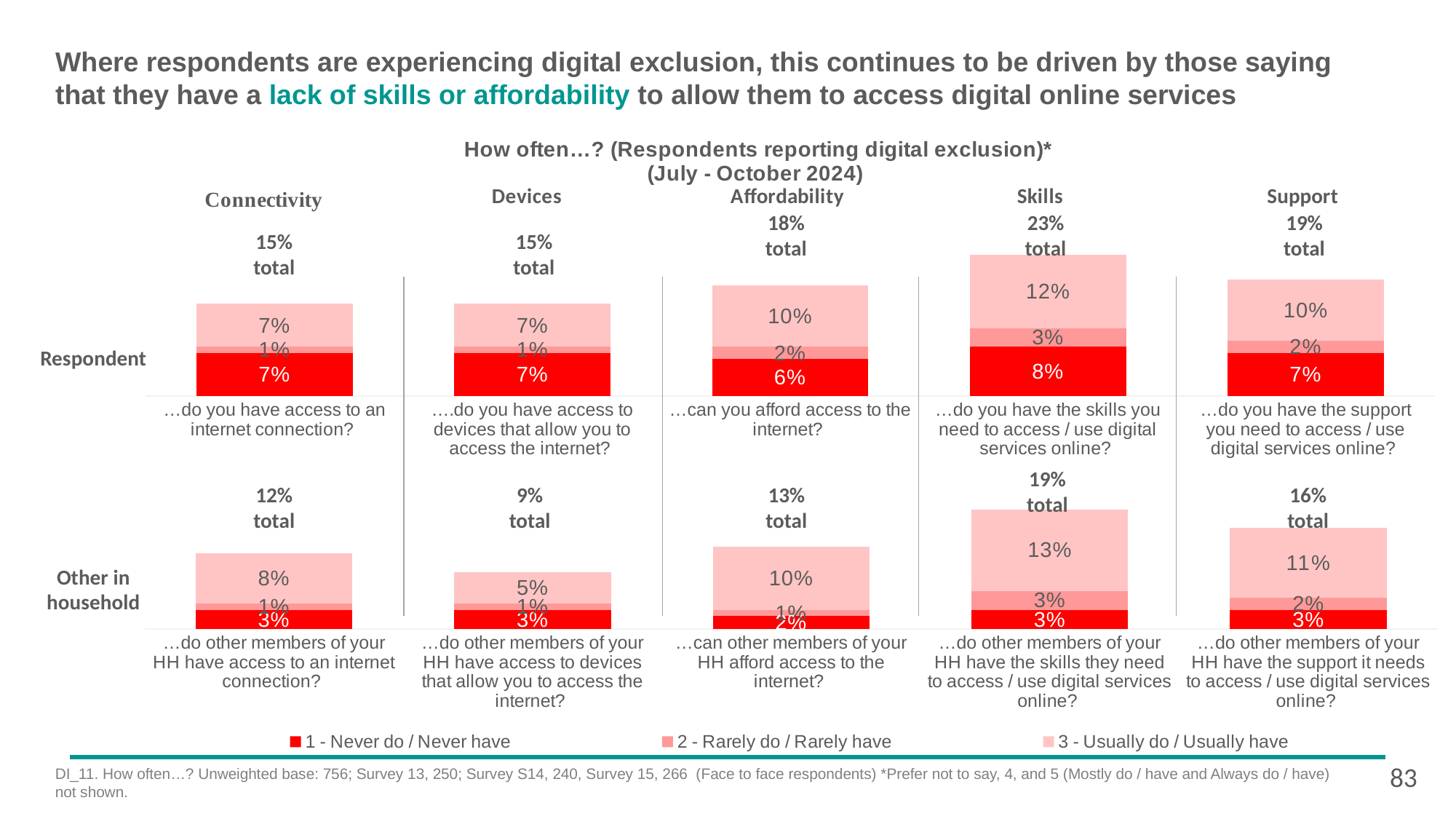
What kind of chart is used to show the Respondent Connectivity data? Stacked bar chart In the Respondent row, what percentage of the Support bar is '2 - Rarely do / Rarely have'? 2% In the Respondent row, which of the five topics has the highest total? Skills What is the difference between the Respondent total for Skills and the Respondent total for Connectivity? 8% In the Respondent row, what is the total for the Skills bar? 23% What colour represents '1 - Never do / Never have' in the legend? Red How many series does the legend list? 3 In the Other in household row, which of the five topics has the lowest total? Devices In the Other in household row, what is the total for the Devices bar? 9% In the Respondent row, what percentage of the Affordability bar is '1 - Never do / Never have'? 6% In the Other in household row, what percentage of the Skills bar is '3 - Usually do / Usually have'? 13% Which is larger: the Other in household total for Support or the Other in household total for Affordability? Support